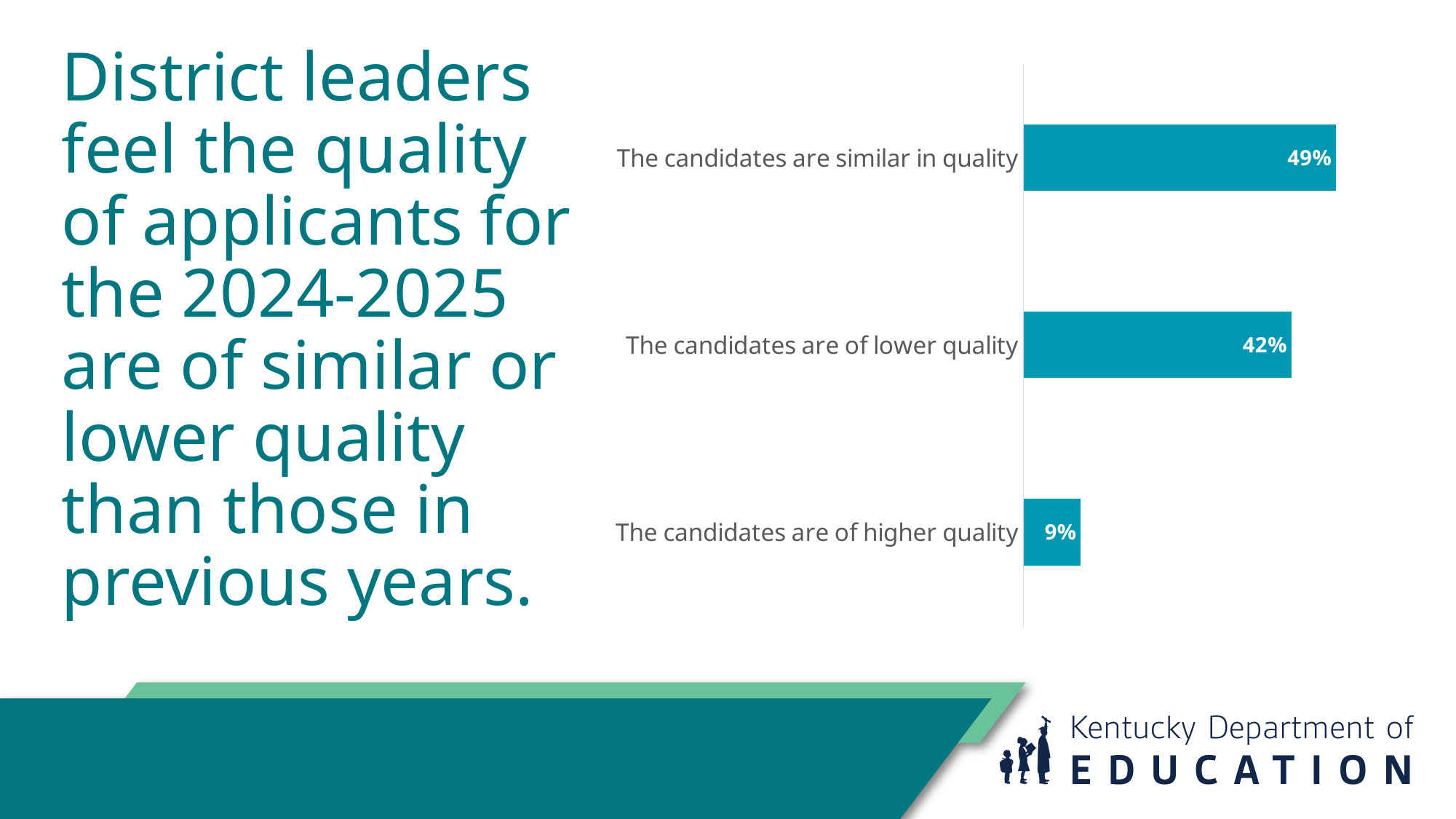
What type of chart is shown on the slide? Bar chart Which response has the lowest percentage? The candidates are of higher quality How many response categories are shown in the chart? 3 What percentage of district leaders said the candidates are similar in quality? 49% What percentage of district leaders said the candidates are of higher quality? 9% What is the combined percentage of district leaders who said candidates are similar in quality or of lower quality? 91% What colour are the bars in the chart? Teal/blue What is the difference in percentage points between 'The candidates are similar in quality' and 'The candidates are of lower quality'? 7 percentage points Which is larger: the percentage for 'The candidates are of lower quality' or 'The candidates are of higher quality'? The candidates are of lower quality What is the difference in percentage points between 'The candidates are of lower quality' and 'The candidates are of higher quality'? 33 percentage points Which response has the highest percentage? The candidates are similar in quality What percentage of district leaders said the candidates are of lower quality? 42%